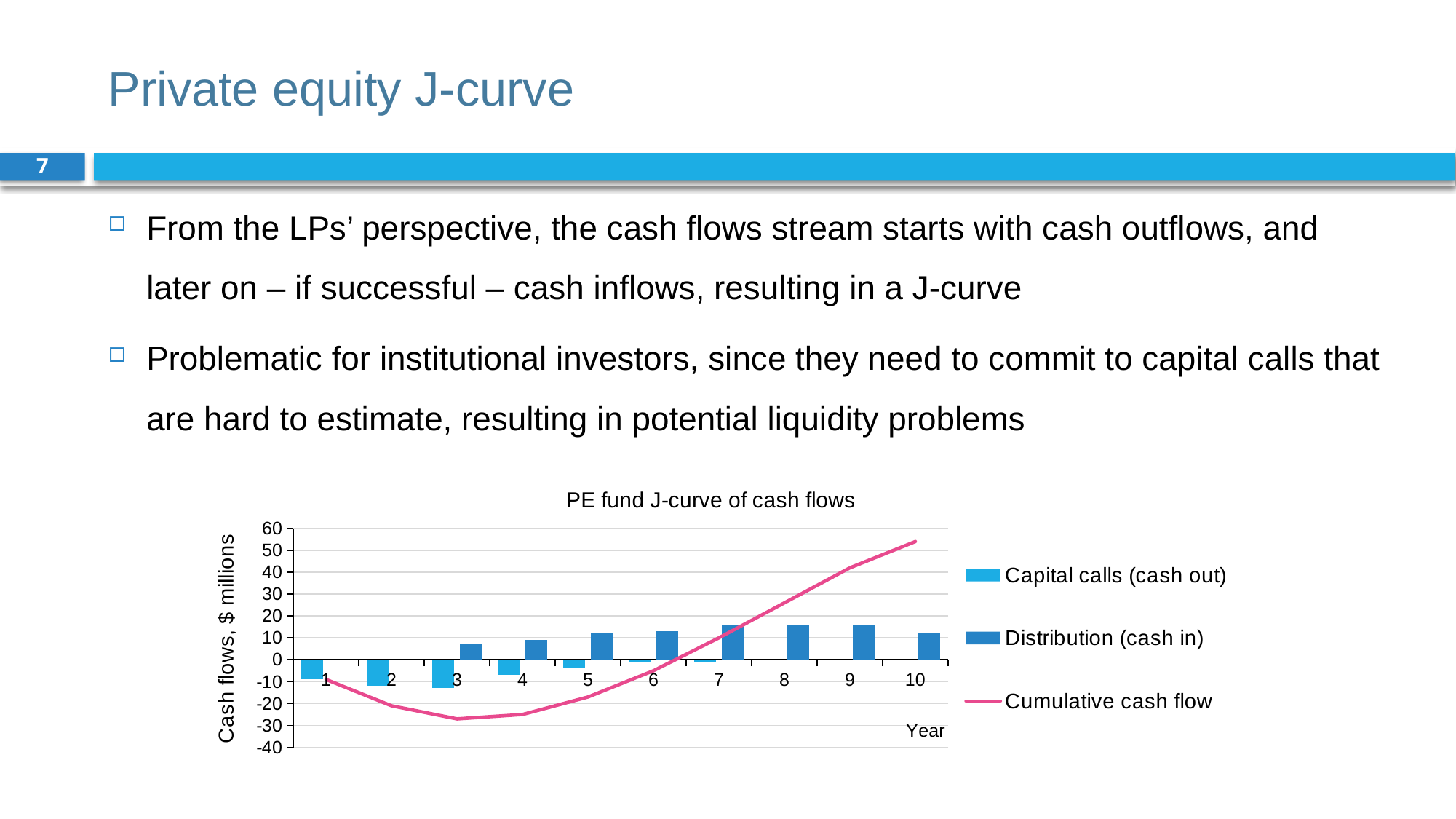
Which is larger, the Distribution (cash in) value in year 8 or in year 3? Year 8 How many series does the chart's legend list? 3 What is the label of the vertical axis of the chart? Cash flows, $ millions Is the Cumulative cash flow value in year 10 greater or less than 50? greater Is the Distribution (cash in) value in year 8 greater or less than 10? greater Is the Capital calls (cash out) value in year 1 greater or less than 0? less What is the title of the chart on the slide? PE fund J-curve of cash flows How many years are shown on the x axis of the chart? 10 Does the Cumulative cash flow line rise or fall from year 3 to year 10? Rises Does the Cumulative cash flow line rise or fall from year 1 to year 3? Falls What kind of chart is shown on the slide? Combined bar and line chart